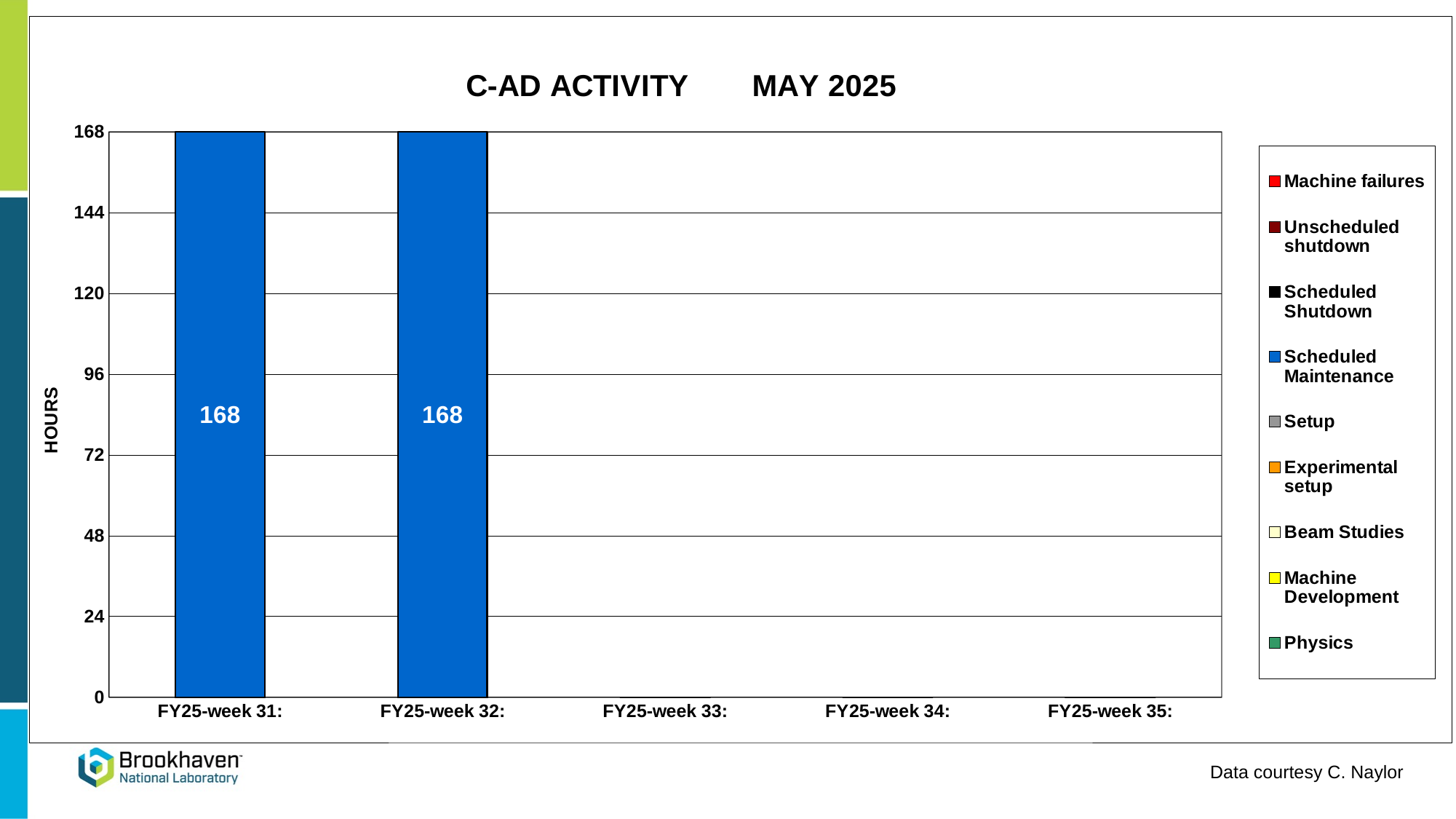
What is the maximum value shown on the y axis? 168 What is the difference between the Scheduled Maintenance values for FY25-week 31 and FY25-week 32? 0 How many series does the legend list? 9 Is the value for FY25-week 31 greater or less than 144? greater What is the Scheduled Maintenance value for FY25-week 31? 168 How many categories are shown on the x axis? 5 What kind of chart is shown? bar chart What is the label of the y axis? HOURS What is the title of the chart? C-AD ACTIVITY MAY 2025 Which series do the plotted bars belong to? Scheduled Maintenance What is the Scheduled Maintenance value for FY25-week 32? 168